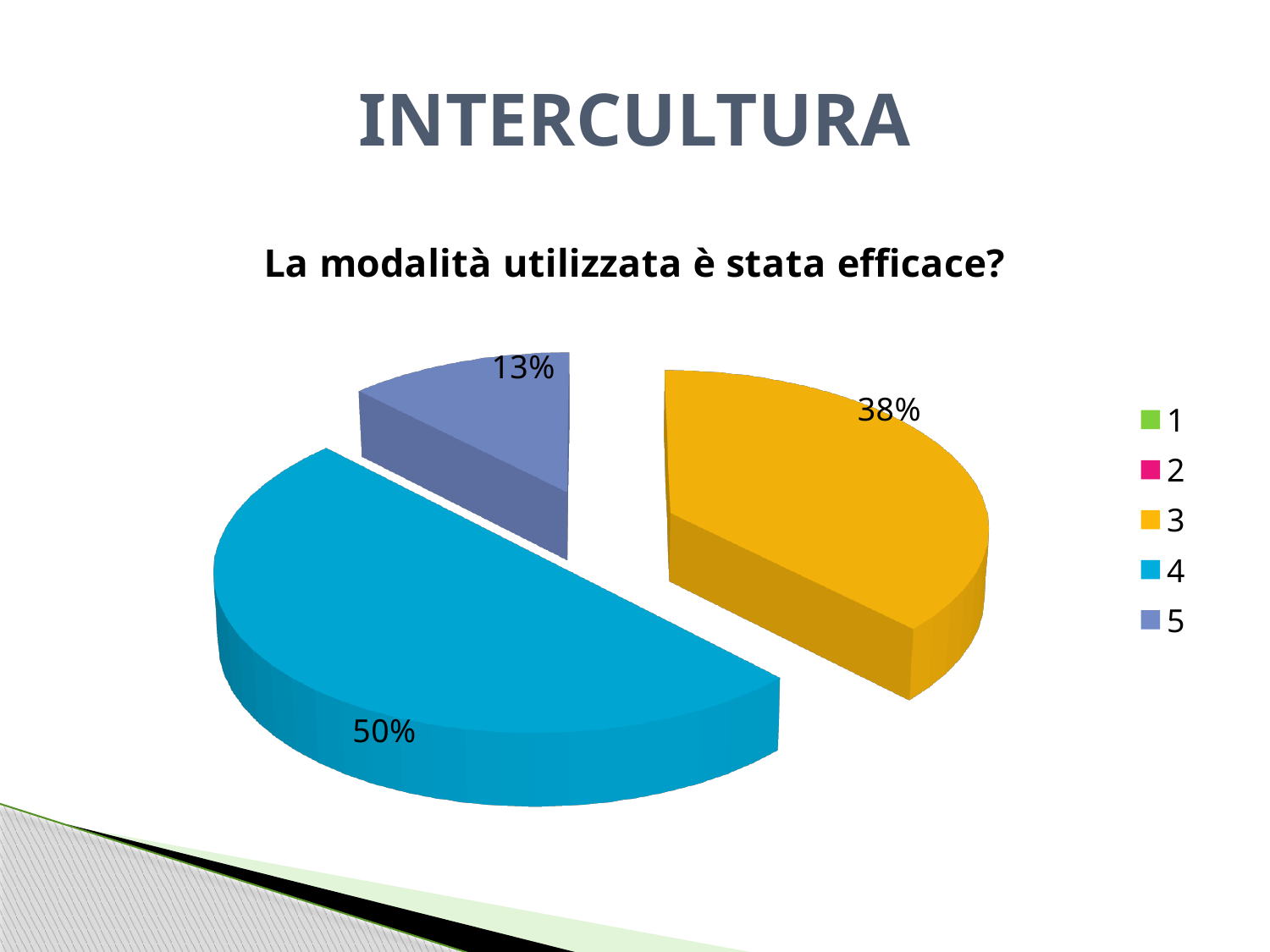
How many entries does the legend list? 5 What is the difference in percentage points between the slices for category 4 and category 3? 12 What colour is the slice for category 4? blue What share of the pie does category 4 have? 50% What is the chart's title? La modalità utilizzata è stata efficace? Which category has the largest slice of the pie? 4 Which is larger, the slice for category 3 or the slice for category 5? 3 How many slices are visible in the pie? 3 What kind of chart is shown on the slide? pie chart Which of the visible slices is the smallest? 5 What share of the pie does category 5 have? 13% What share of the pie does category 3 have? 38%